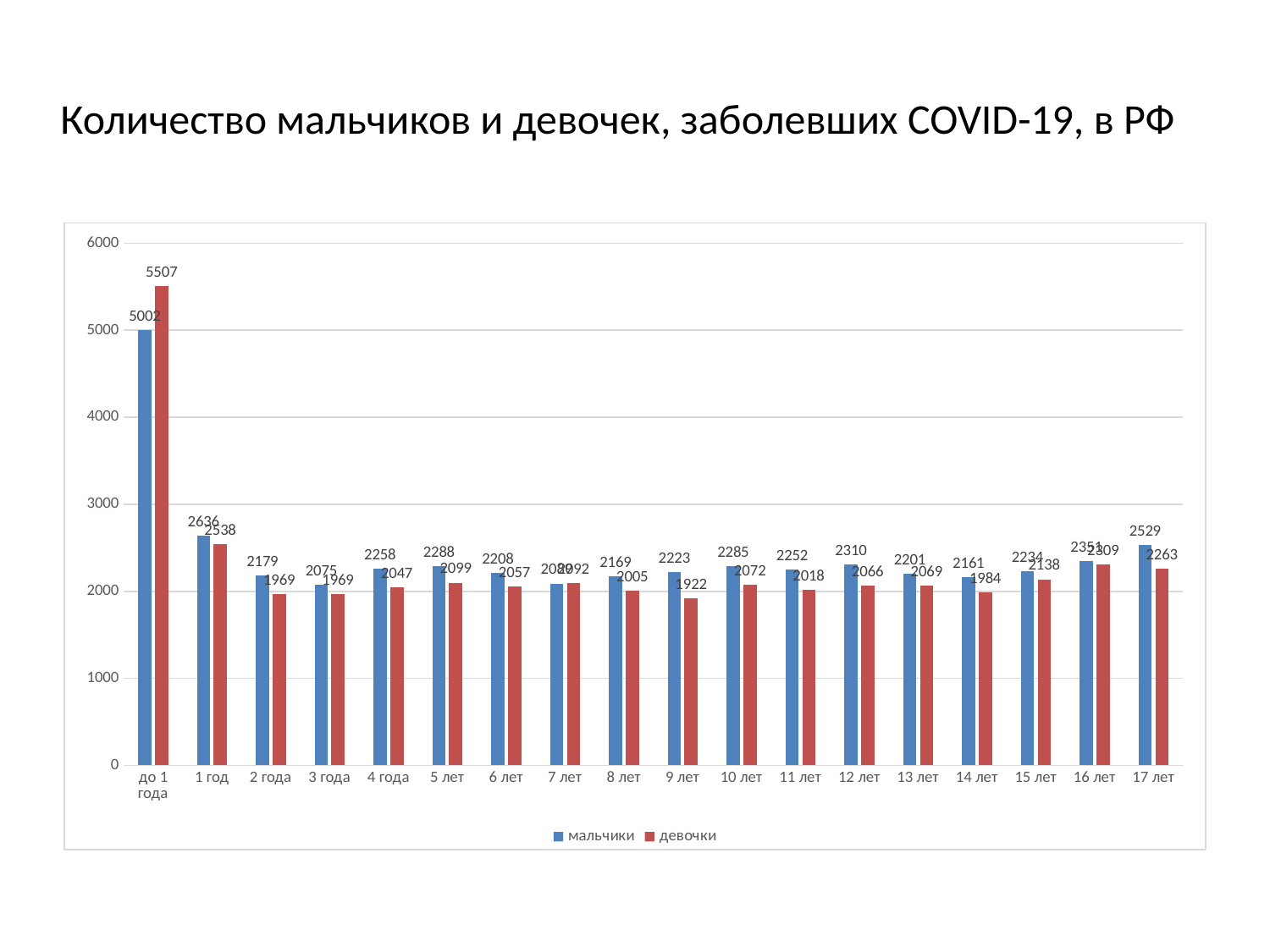
What is the value for мальчики in the category 12 лет? 2310 What type of chart is shown on the slide? bar chart What is the value for девочки in the category до 1 года? 5507 How many series does the legend list? 2 How many age categories are shown on the x axis? 18 Is the value for мальчики in the category 17 лет greater or less than 3000? less What is the difference between девочки and мальчики in the category до 1 года? 505 What is the title of the chart? Количество мальчиков и девочек, заболевших COVID-19, в РФ Which age category has the lowest value for девочки? 9 лет Which is larger in the category 1 год: мальчики or девочки? мальчики What is the value for девочки in the category 9 лет? 1922 Which age category has the highest value for мальчики? до 1 года